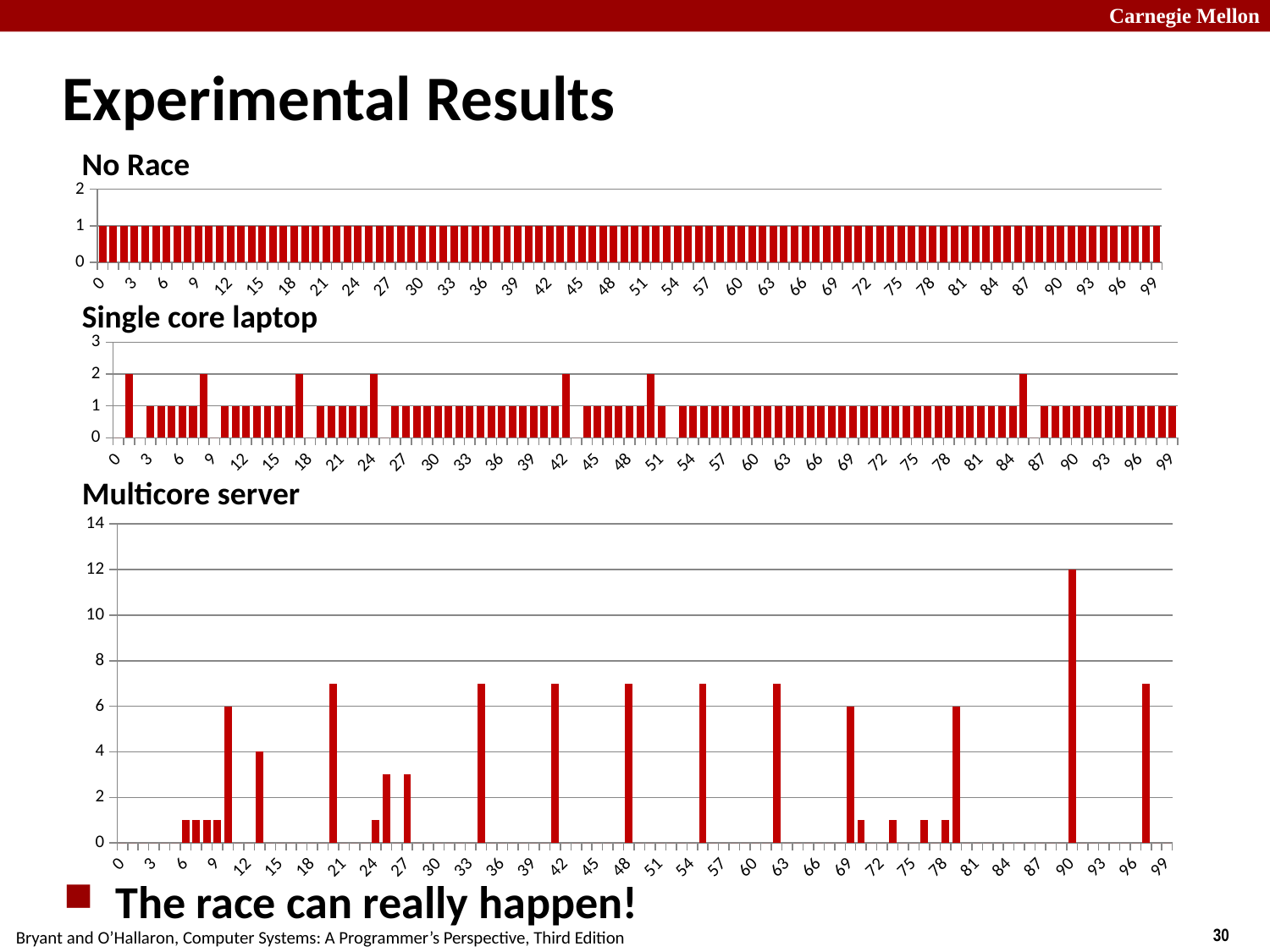
In the "Multicore server" chart, what is the highest value reached by any bar? 12 What kind of chart is the "Multicore server" chart? bar chart How many charts are shown on the slide? 3 In the "Single core laptop" chart, what is the highest value reached by any bar? 2 Which chart has the larger maximum bar value, "No Race" or "Multicore server"? Multicore server In the "No Race" chart, what value do all the bars reach? 1 What is the title of the bottom chart on the slide? Multicore server In the "Multicore server" chart, at which x-axis position does the tallest bar occur? 90 What is the highest value shown on the y axis of the "Multicore server" chart? 14 In the "Multicore server" chart, is the tallest bar greater or less than 10? greater